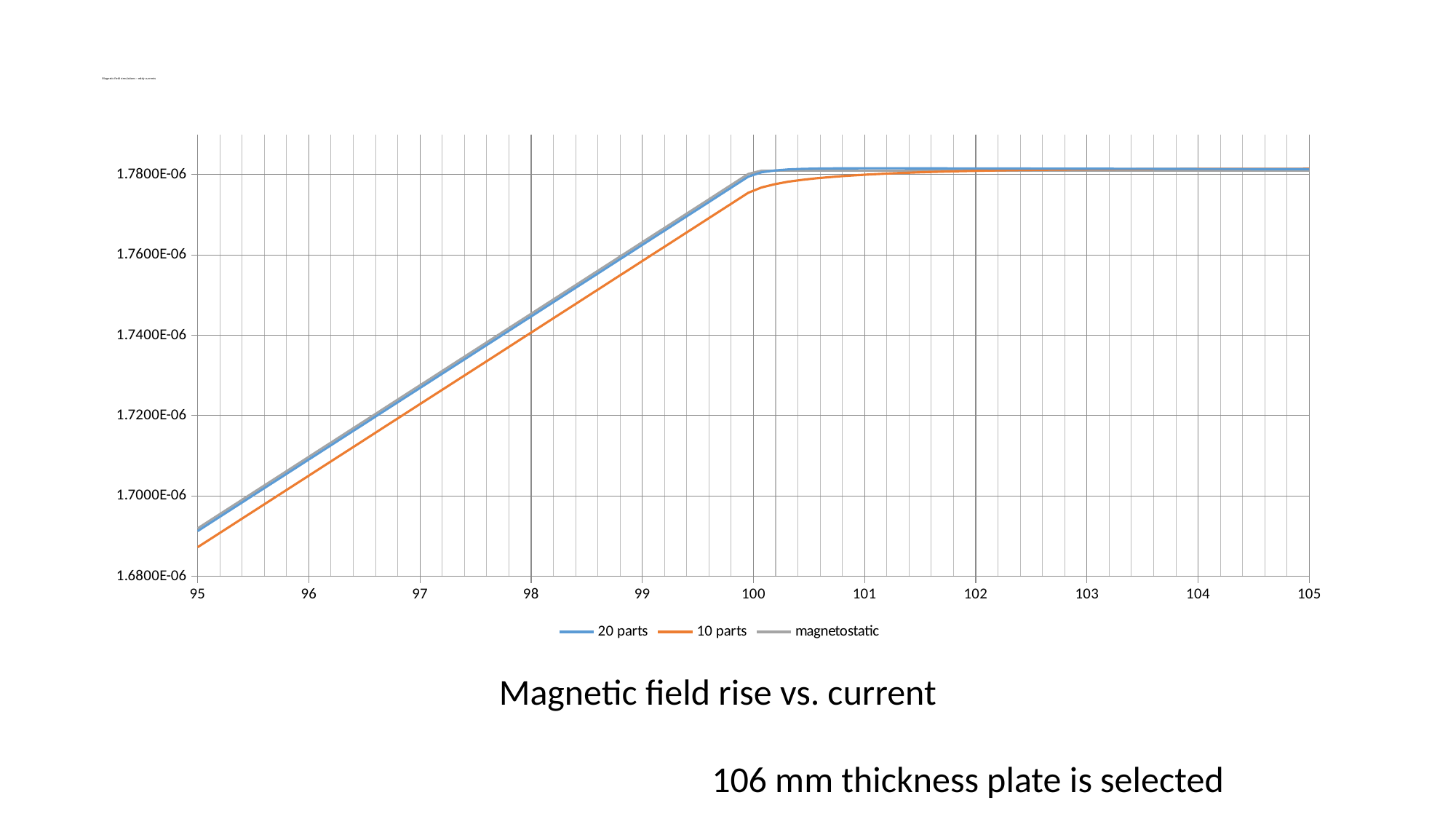
Is the value of the 10 parts series at x = 96 greater or less than 1.7000E-06? greater At x = 97, which series has the higher value, 20 parts or 10 parts? 20 parts Is the value of the 20 parts series at x = 97 greater or less than 1.7200E-06? greater How many labelled tick values are shown on the x axis? 11 What are the three series named in the chart's legend? 20 parts, 10 parts, magnetostatic Which colour is used for the 10 parts series? orange What kind of chart is shown on the slide? line chart How many series does the chart's legend list? 3 At x = 96, which series has the lowest value? 10 parts Between x = 95 and x = 100, do the plotted values rise or fall? rise Is the value of the 20 parts series at x = 95 greater or less than 1.7000E-06? less